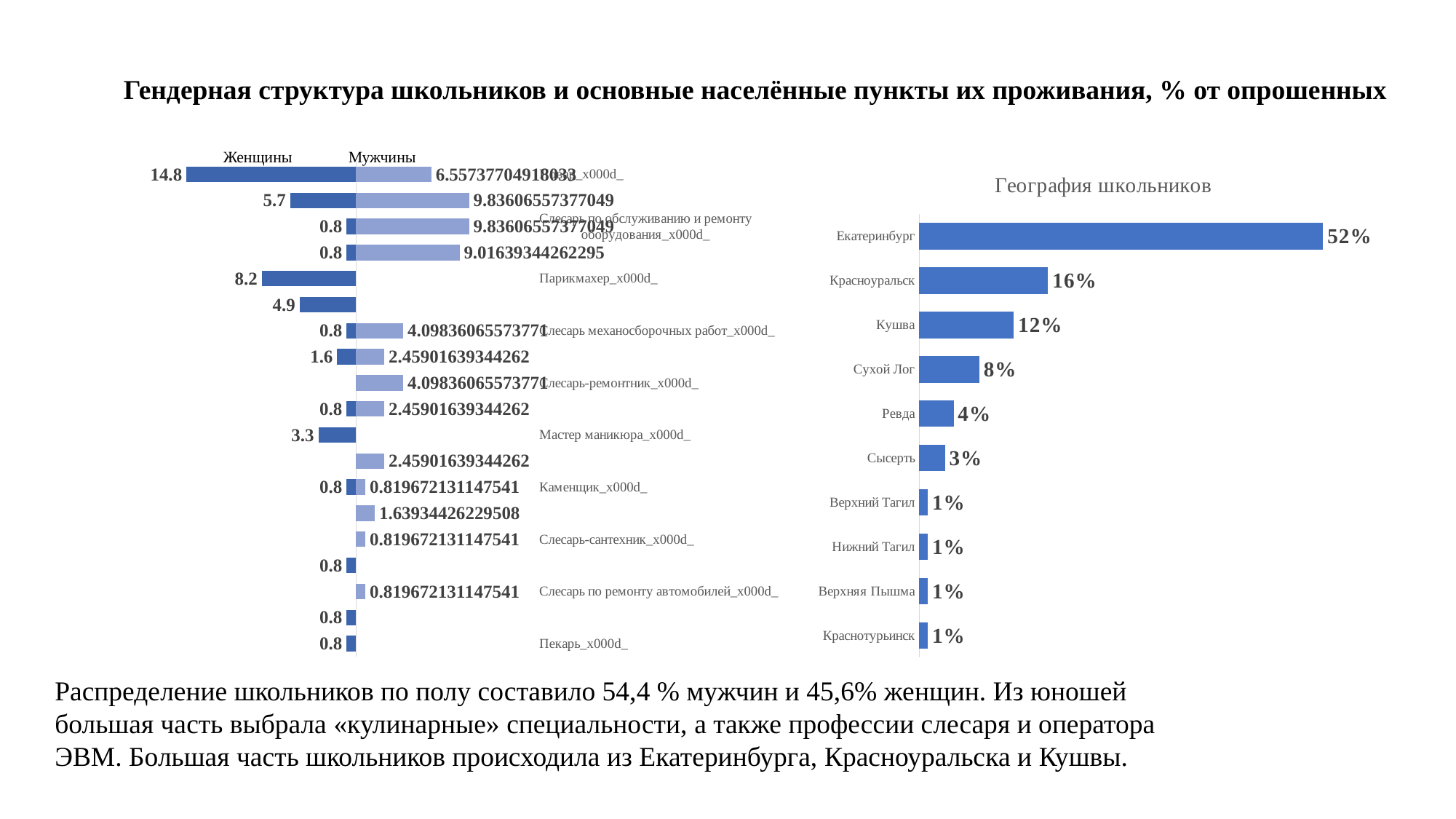
How many cities are shown in the 'География школьников' chart? 10 What kind of chart is the 'География школьников' chart? Bar chart In the 'География школьников' chart, what is the value for Красноуральск? 16% In the 'География школьников' chart, what is the value for Екатеринбург? 52% In the 'География школьников' chart, which city has the highest value? Екатеринбург In the 'География школьников' chart, what is the value for Кушва? 12% In the left chart, what is the highest value shown for the Женщины series? 14.8 In the 'География школьников' chart, which is larger: the value for Кушва or the value for Сухой Лог? Кушва In the 'География школьников' chart, what is the difference between the values for Екатеринбург and Красноуральск? 36% In the 'География школьников' chart, what is the value for Сысерть? 3% In the 'География школьников' chart, what is the difference between the values for Сухой Лог and Ревда? 4% How many series does the legend of the left chart list? 2